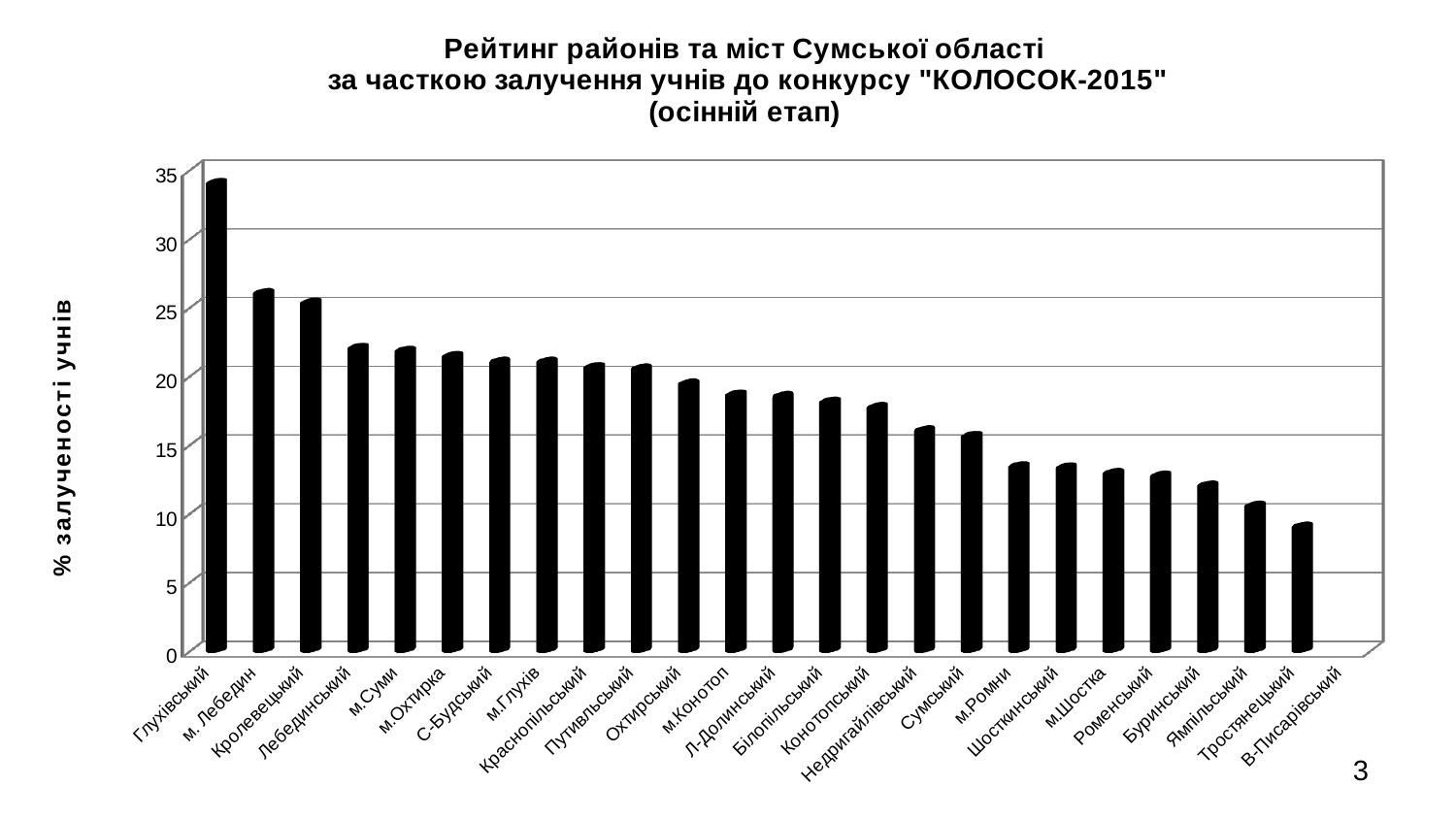
Which category has the highest bar? Глухівський What is the label of the y axis? % залученості учнів Is the value for м.Ромни greater or less than 15? less Is the value for Глухівський greater or less than 30? greater Is the value for Лебединський greater or less than 20? greater Do the values rise or fall from left to right along the x axis? fall What kind of chart is shown on the slide? bar chart Which has a larger value, Глухівський or м.Суми? Глухівський Which has a larger value, Білопільський or Буринський? Білопільський Which category has the lowest bar shown on the chart? Тростянецький